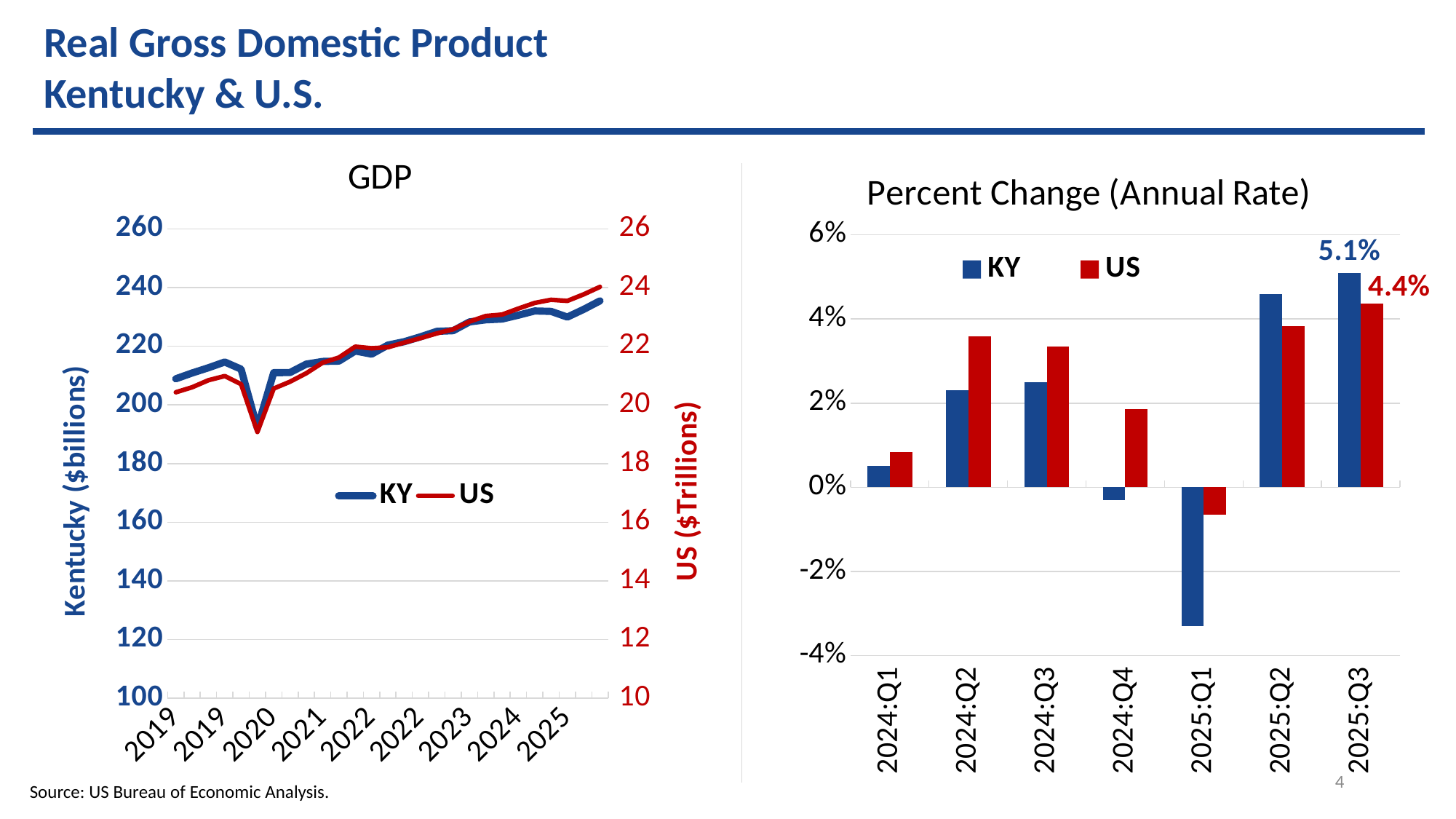
In the Percent Change (Annual Rate) chart, what is the difference between the KY and US values in 2025:Q3? 0.7% How many series does the legend of the GDP chart list? 2 What kind of chart is the GDP chart on the left? line chart In the Percent Change (Annual Rate) chart, what is the value for US in 2025:Q3? 4.4% In the Percent Change (Annual Rate) chart, in which quarter is the KY value lowest? 2025:Q1 In the Percent Change (Annual Rate) chart, what is the value for KY in 2025:Q3? 5.1% In the Percent Change (Annual Rate) chart, in which quarter is the US value highest? 2025:Q3 In the GDP chart, do the KY and US lines generally rise or fall from 2019 to 2025? rise In the Percent Change (Annual Rate) chart, is the value for KY in 2025:Q1 greater or less than -2%? less In the Percent Change (Annual Rate) chart, is the value for US in 2024:Q2 greater or less than 2%? greater In the Percent Change (Annual Rate) chart, which is larger in 2025:Q3, KY or US? KY How many quarters are shown on the x axis of the Percent Change (Annual Rate) chart? 7